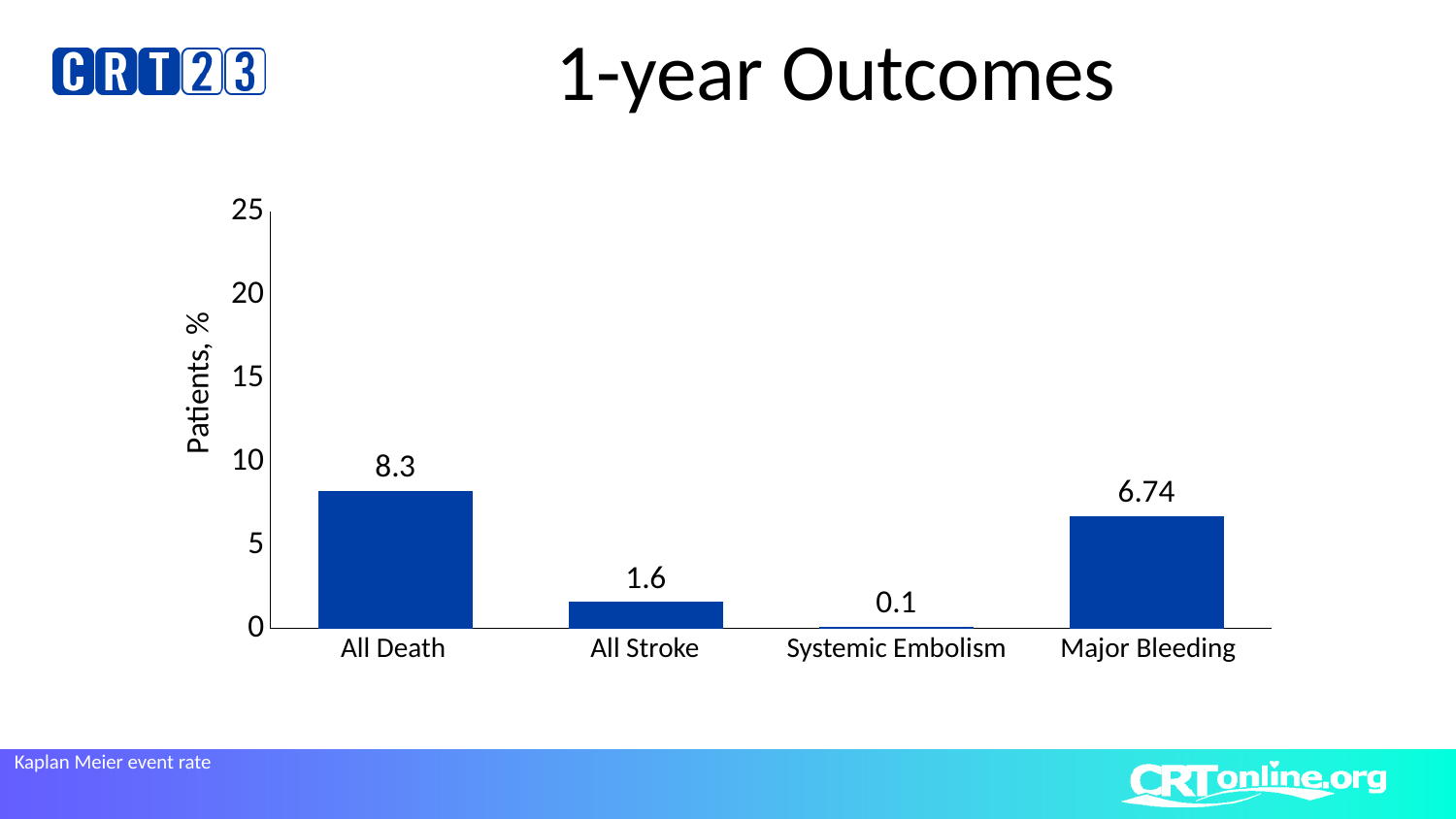
What is the label of the y axis? Patients, % Which is larger, the value for All Stroke or the value for Major Bleeding? Major Bleeding What kind of chart is shown on the slide? bar chart Which category has the lowest value? Systemic Embolism Is the value for All Death greater or less than 10? less What is the difference between the values for All Stroke and Systemic Embolism? 1.5 What is the value for All Death? 8.3 What is the value for Systemic Embolism? 0.1 How many categories are shown on the x axis? 4 Which category has the highest value? All Death What is the value for Major Bleeding? 6.74 What is the difference between the values for All Death and Major Bleeding? 1.56